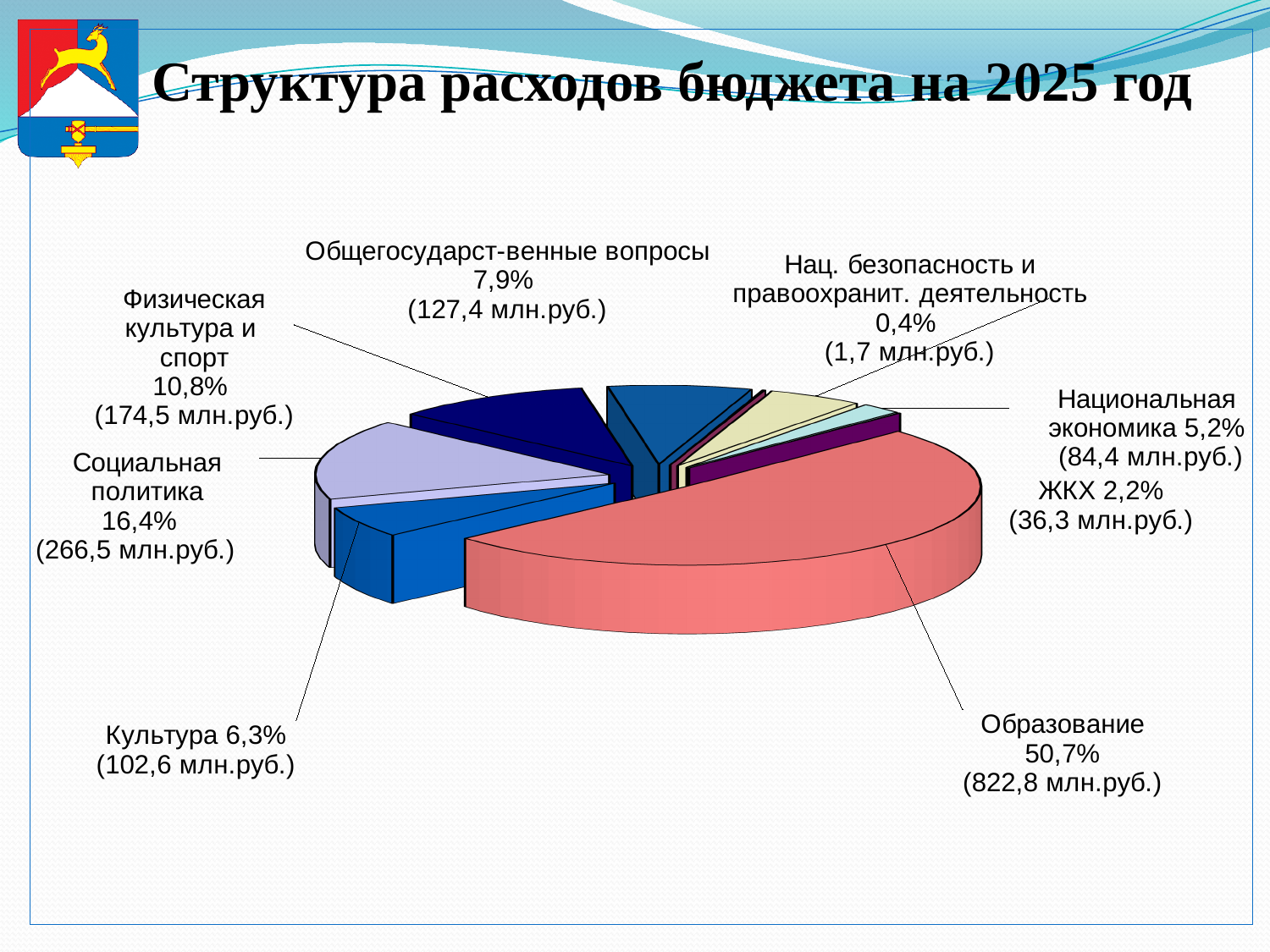
What kind of chart is shown on the slide? Pie chart What is the amount in млн.руб. for Социальная политика? 266,5 млн.руб. What is the difference in млн.руб. between ЖКХ and Нац. безопасность и правоохранит. деятельность? 34,6 млн.руб. What percentage is shown for Физическая культура и спорт? 10,8% Which is larger: the share for Культура or the share for Национальная экономика? Культура What is the difference in percentage points between Образование and Социальная политика? 34,3 Which category has the largest share of the budget expenditure? Образование What is the amount in млн.руб. for Общегосударственные вопросы? 127,4 млн.руб. What share of the budget expenditure goes to Образование? 50,7% What is the title of the chart on the slide? Структура расходов бюджета на 2025 год